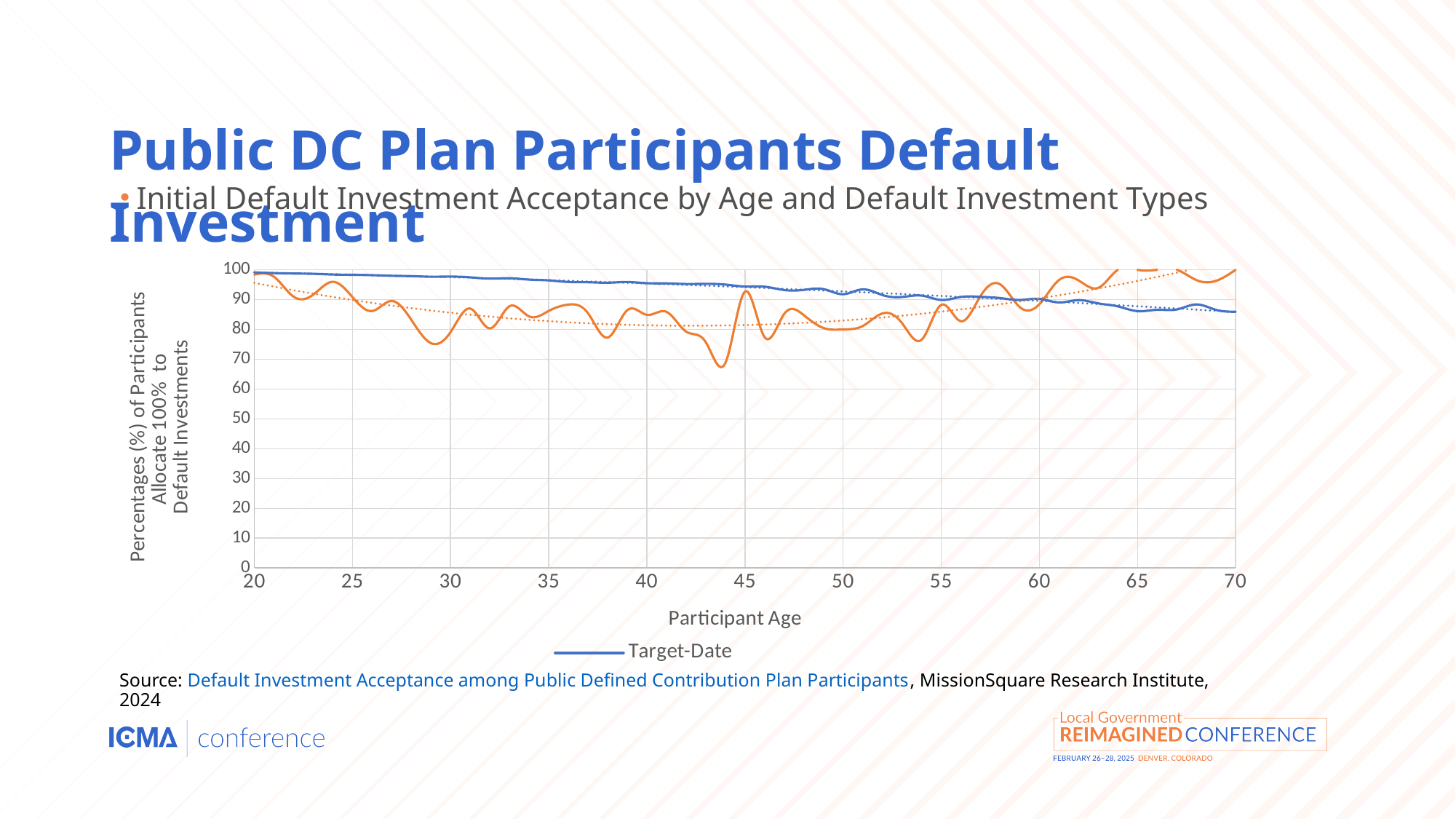
Is the value for the orange series at age 29 greater or less than 80? less Is the value for the orange series at age 44 greater or less than 80? less Is the value for the orange series at age 62 greater or less than 90? greater At age 70, which series has the higher value, the Target-Date series or the orange series? the orange series At age 30, which series has the higher value, the Target-Date series or the orange series? Target-Date What kind of chart is shown on the slide? line chart What is the label of the x axis? Participant Age Does the Target-Date series generally rise or fall as participant age increases from 20 to 70? fall What is the highest value shown on the y axis? 100 What is the title of the chart? Initial Default Investment Acceptance by Age and Default Investment Types